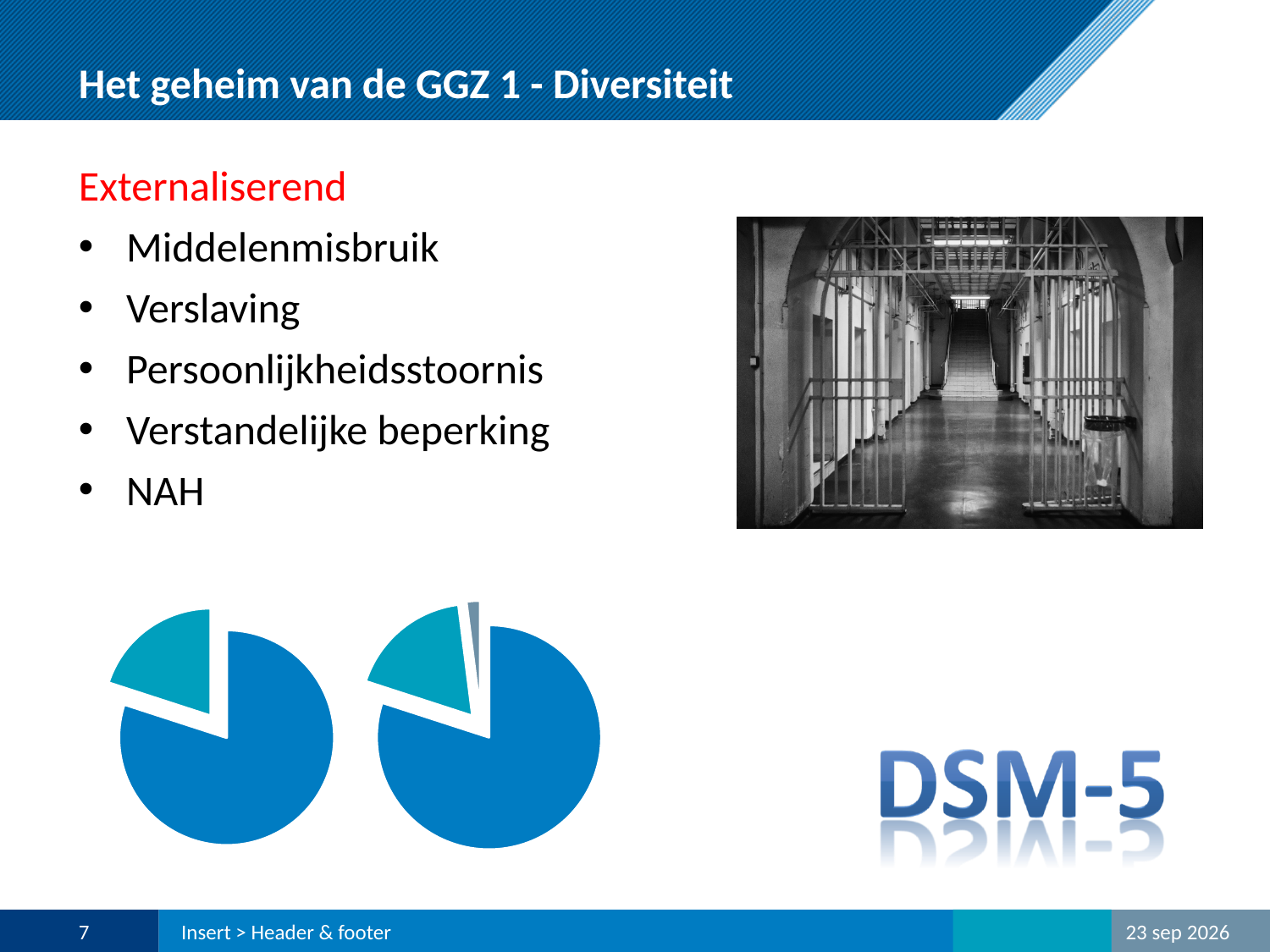
In the right pie chart, which slice is the smallest, the dark blue, the teal or the grey one? the grey one How many slices does the right pie chart have? 3 How many slices does the left pie chart have? 2 In the left pie chart, which slice is the largest, the dark blue one or the teal one? the dark blue one Do the pie charts on the slide show a legend? No What kind of chart is the right chart at the bottom of the slide? pie chart In the right pie chart, which slice is larger, the teal one or the grey one? the teal one What kind of chart is the left chart at the bottom of the slide? pie chart Do the pie charts on the slide show data labels with values? No